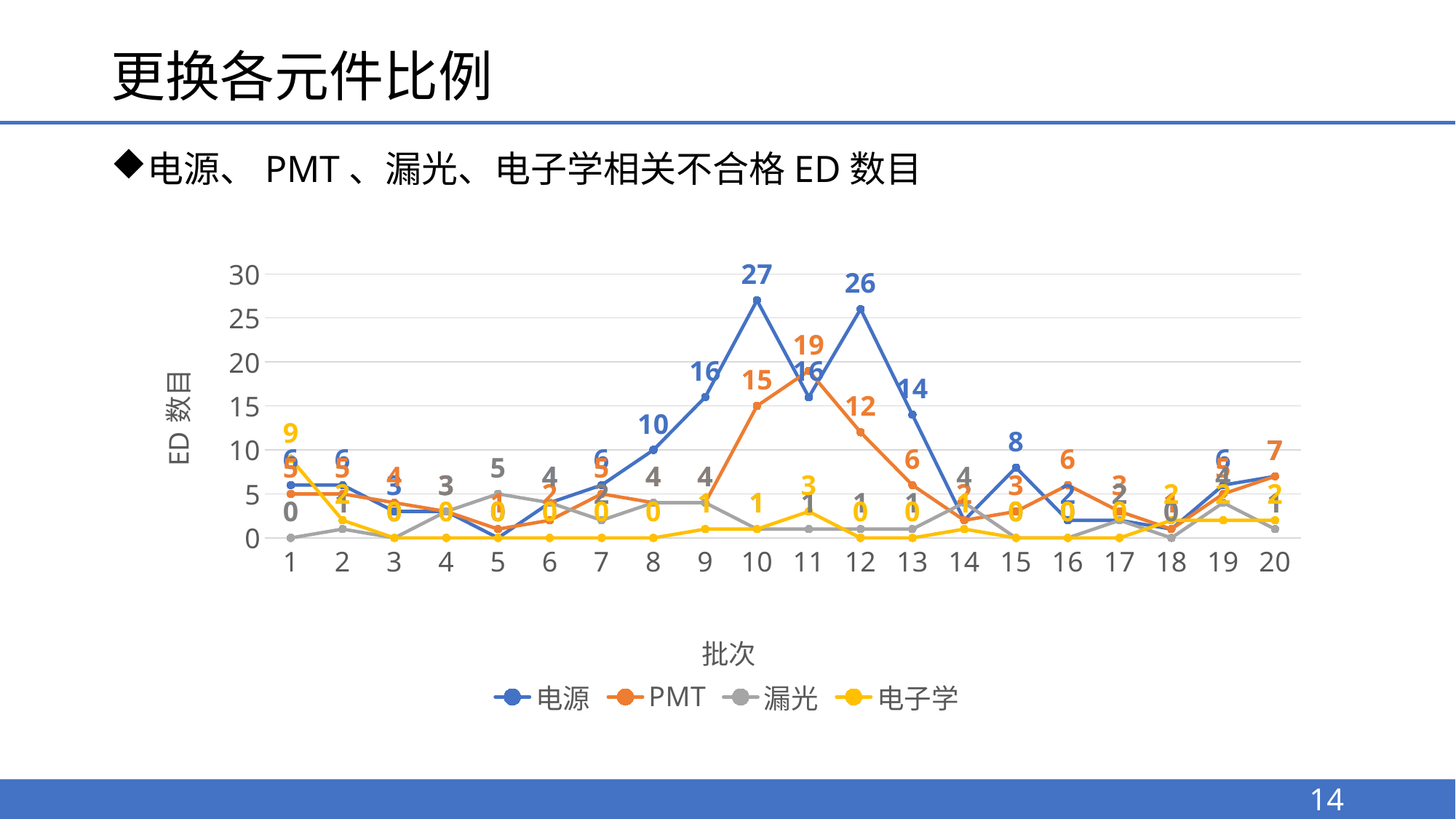
What is the value of 电子学 at batch 1? 9 At batch 10, which series has the larger value, 电源 or PMT? 电源 What is the value of 电源 at batch 13? 14 By how much does the PMT value at batch 11 exceed its value at batch 10? 4 What is the label of the vertical axis? ED 数目 What is the difference between the 电源 values at batch 10 and batch 12? 1 How many batches (批次) are plotted along the x axis? 20 At which batch does the 电源 series reach its highest value? 10 How many series does the legend list? 4 What is the value of 电源 at batch 10? 27 What is the value of PMT at batch 11? 19 What kind of chart is shown on the slide? line chart